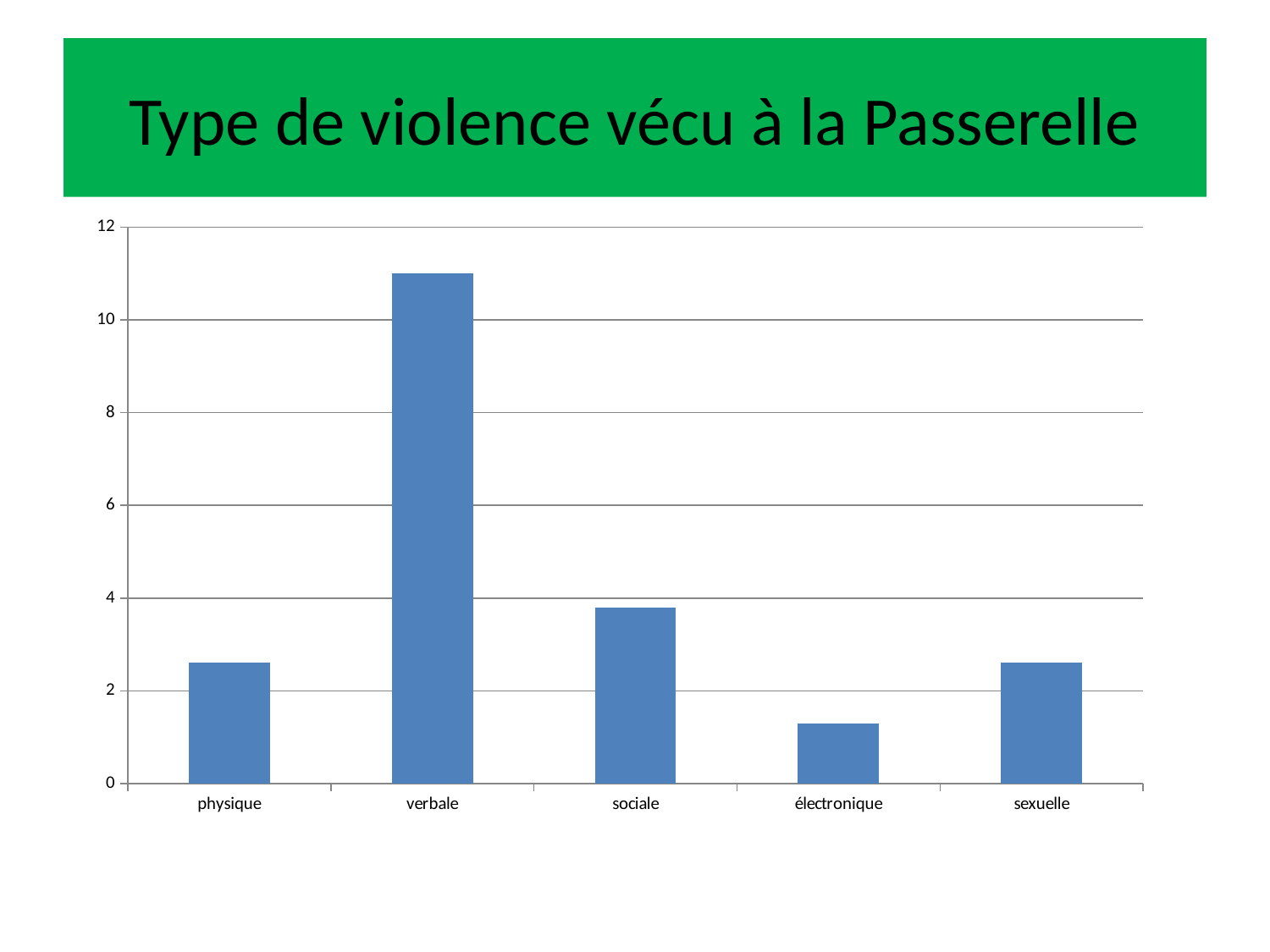
Is the value for électronique greater or less than 2? less Which is larger, the value for sociale or the value for électronique? sociale What is the title of the slide? Type de violence vécu à la Passerelle Which category has the lowest value? électronique Is the value for sociale greater or less than 4? less Which is larger, the value for verbale or the value for sociale? verbale Is the value for sexuelle greater or less than 4? less What kind of chart is shown on the slide? bar chart How many categories are shown on the x axis? 5 Which category has the highest value? verbale